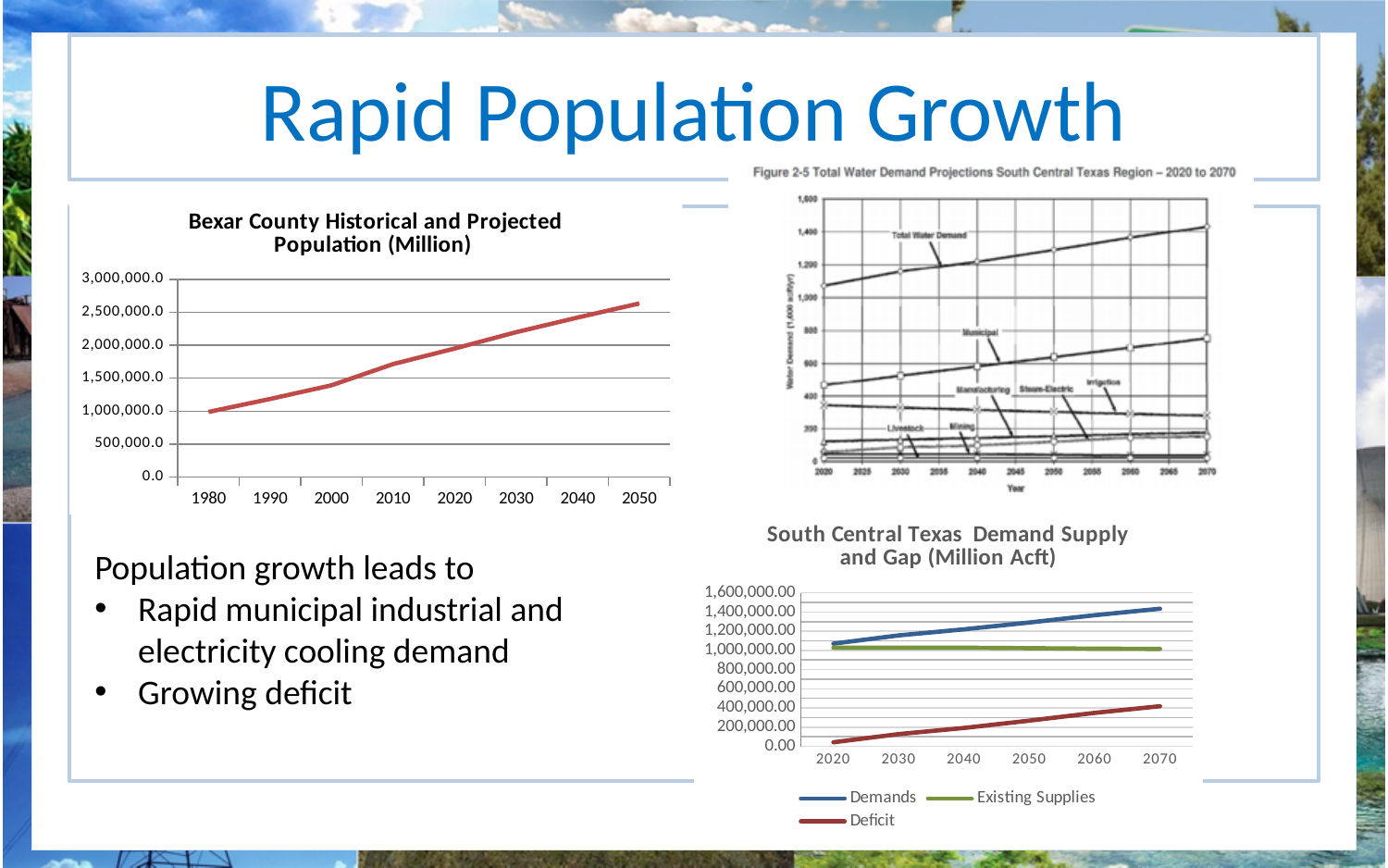
In the 'Figure 2-5 Total Water Demand Projections South Central Texas Region – 2020 to 2070' chart, which series has the highest values? Total Water Demand In the 'Bexar County Historical and Projected Population (Million)' chart, is the value for 2000 greater or less than 1,500,000.0? less How many years are labelled on the x axis of the 'Bexar County Historical and Projected Population (Million)' chart? 8 In the 'South Central Texas Demand Supply and Gap (Million Acft)' chart, which series is higher in 2070, Demands or Existing Supplies? Demands What type of chart is the 'Bexar County Historical and Projected Population (Million)' chart? line chart In the 'South Central Texas Demand Supply and Gap (Million Acft)' chart, which series is shown in red? Deficit In the 'South Central Texas Demand Supply and Gap (Million Acft)' chart, is the Deficit value for 2070 greater or less than 600,000.00? less In the 'Bexar County Historical and Projected Population (Million)' chart, is the value for 2050 greater or less than 2,500,000.0? greater In the 'Bexar County Historical and Projected Population (Million)' chart, does the population rise or fall from 1980 to 2050? rise How many series does the legend of the 'South Central Texas Demand Supply and Gap (Million Acft)' chart list? 3 In the 'South Central Texas Demand Supply and Gap (Million Acft)' chart, does the Deficit series rise or fall from 2020 to 2070? rise